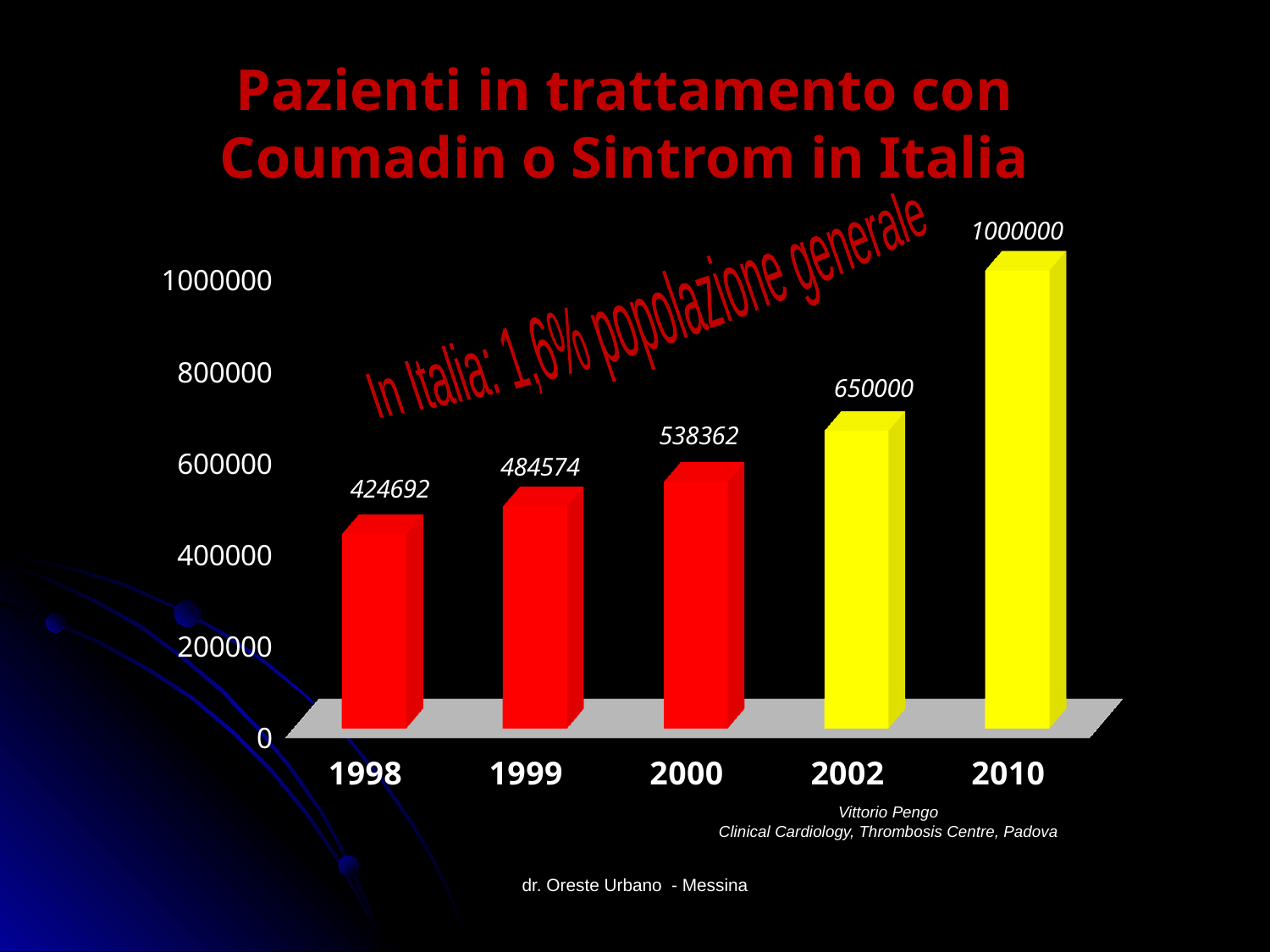
What is the value for 1998? 424692 How many years are shown on the x axis? 5 Which year has the highest value? 2010 Is the value for 2002 greater or less than 600000? greater What is the value for 2010? 1000000 What kind of chart is shown on the slide? bar chart Which year has the lowest value? 1998 Do the values rise or fall from 1998 to 2010? rise What is the value for 2000? 538362 What is the difference between the values for 1999 and 1998? 59882 Which is larger, the value for 2002 or the value for 2000? 2002 What is the difference between the values for 2010 and 2002? 350000